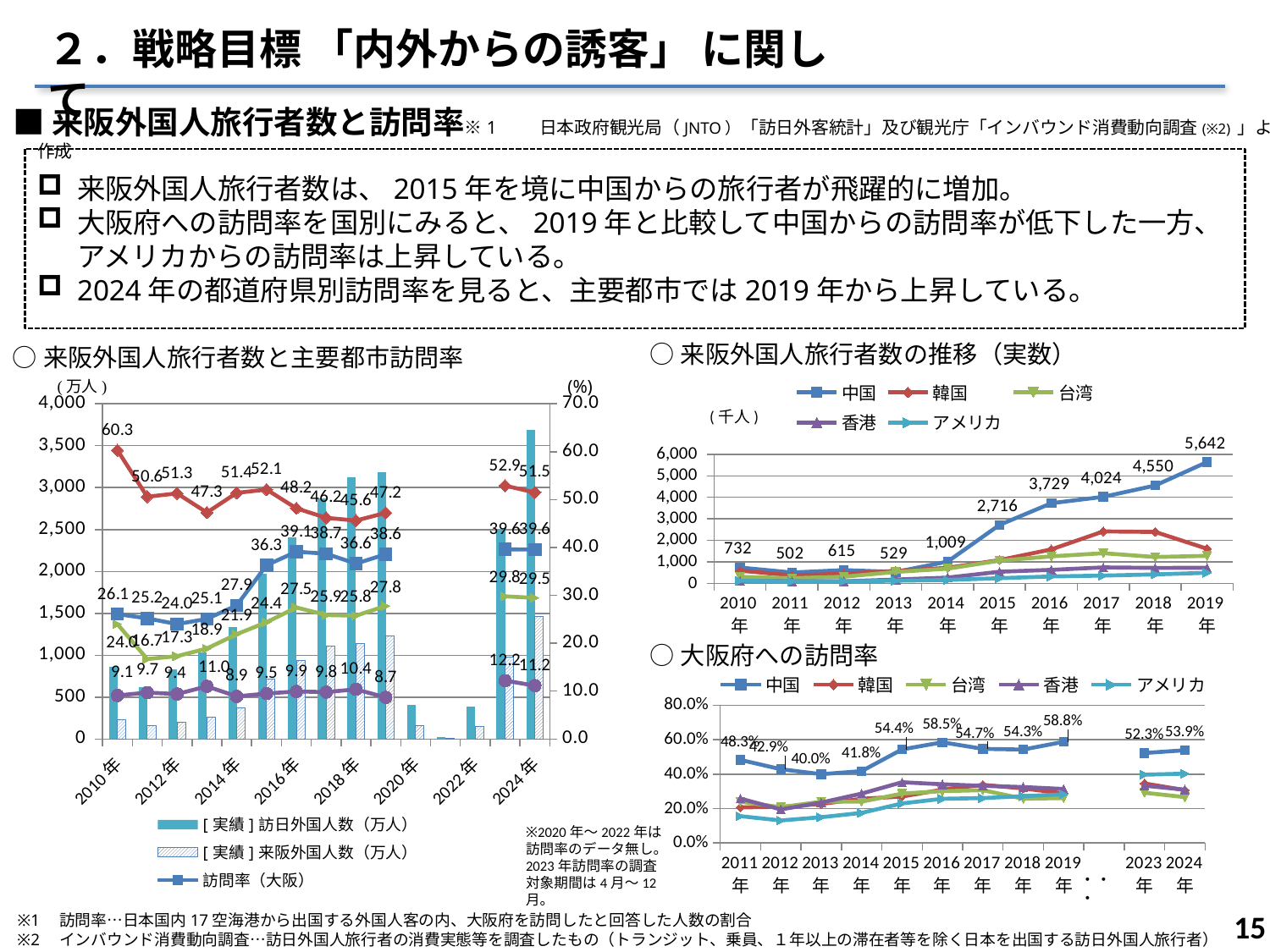
In the chart titled 来阪外国人旅行者数の推移（実数）, what is the value for 中国 in 2019? 5,642 In the chart titled 来阪外国人旅行者数の推移（実数）, how many series does the legend list? 5 In the chart titled 来阪外国人旅行者数と主要都市訪問率, is the 訪日外国人数 bar for 2019 greater or less than 3,000? greater In the chart titled 来阪外国人旅行者数の推移（実数）, what is the difference between the 中国 values for 2019 and 2018? 1,092 In the chart titled 来阪外国人旅行者数の推移（実数）, in which year is the value for 中国 lowest? 2011 In the chart titled 来阪外国人旅行者数と主要都市訪問率, what is the value of 訪問率（大阪） in 2015? 36.3 In the chart titled 来阪外国人旅行者数の推移（実数）, what is the value for 中国 in 2015? 2,716 In the chart titled 大阪府への訪問率, what is the value for 中国 in 2016? 58.5% In the chart titled 大阪府への訪問率, in which year is the value for 中国 lowest? 2013 In the chart titled 大阪府への訪問率, what is the value for 中国 in 2024? 53.9% In the chart titled 来阪外国人旅行者数の推移（実数）, does the value for 中国 rise or fall from 2014 to 2019? rise In the chart titled 大阪府への訪問率, which is larger for 中国: the value in 2019 or the value in 2023? 2019